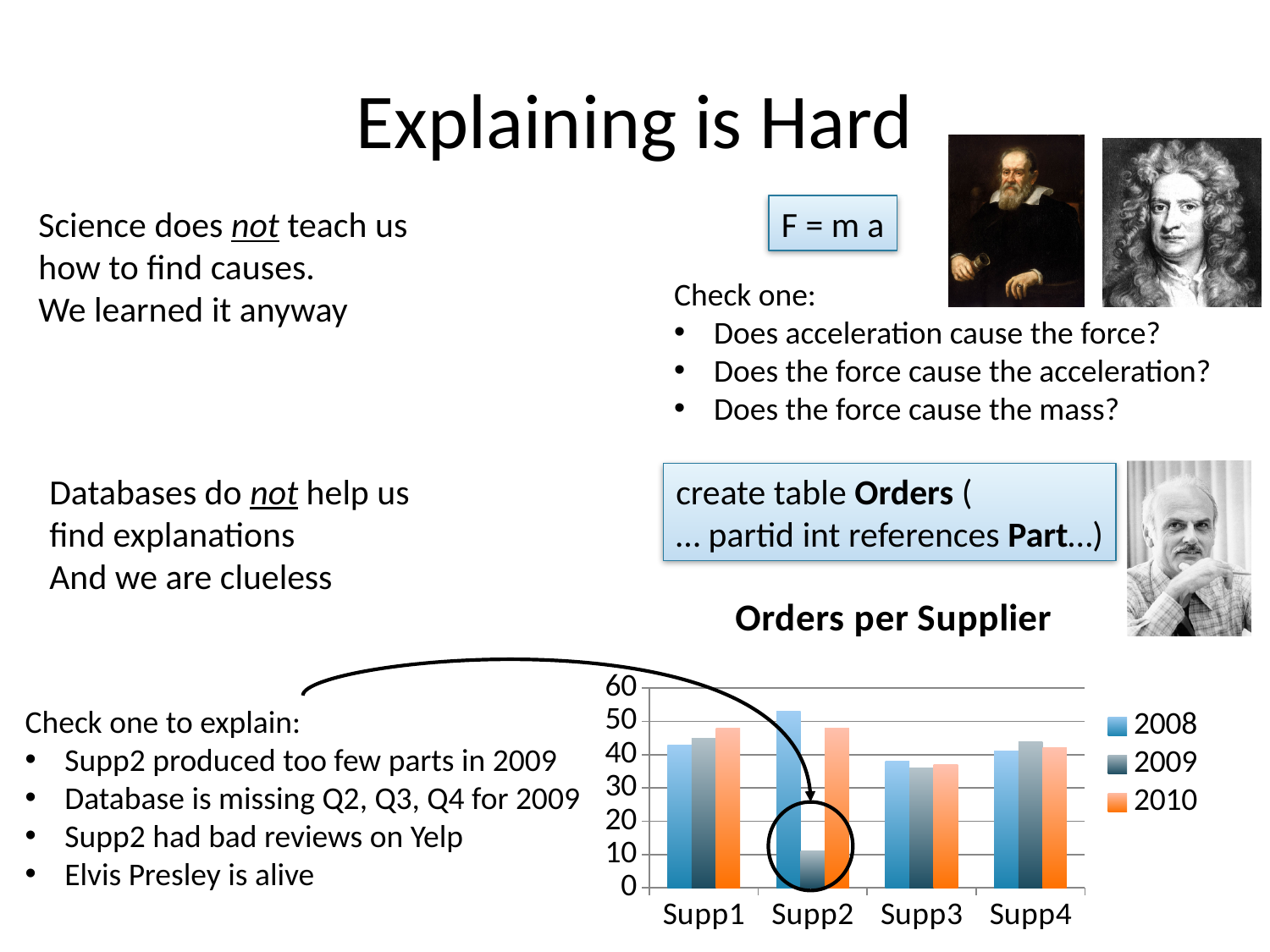
What is the title of the chart? Orders per Supplier What kind of chart is shown on the slide? bar chart Which is larger: the 2010 value for Supp1 or the 2010 value for Supp3? Supp1 Which years are listed in the chart's legend? 2008, 2009, 2010 How many supplier categories are shown on the x axis of the chart? 4 How many series does the chart's legend list? 3 Which supplier has the lowest value for 2009? Supp2 Which supplier has the highest value for 2008? Supp2 Is the 2008 value for Supp2 greater or less than 50? greater For Supp2, which is larger: the 2008 value or the 2009 value? 2008 Is the 2009 value for Supp2 greater or less than 20? less Is the 2009 value for Supp3 greater or less than 40? less